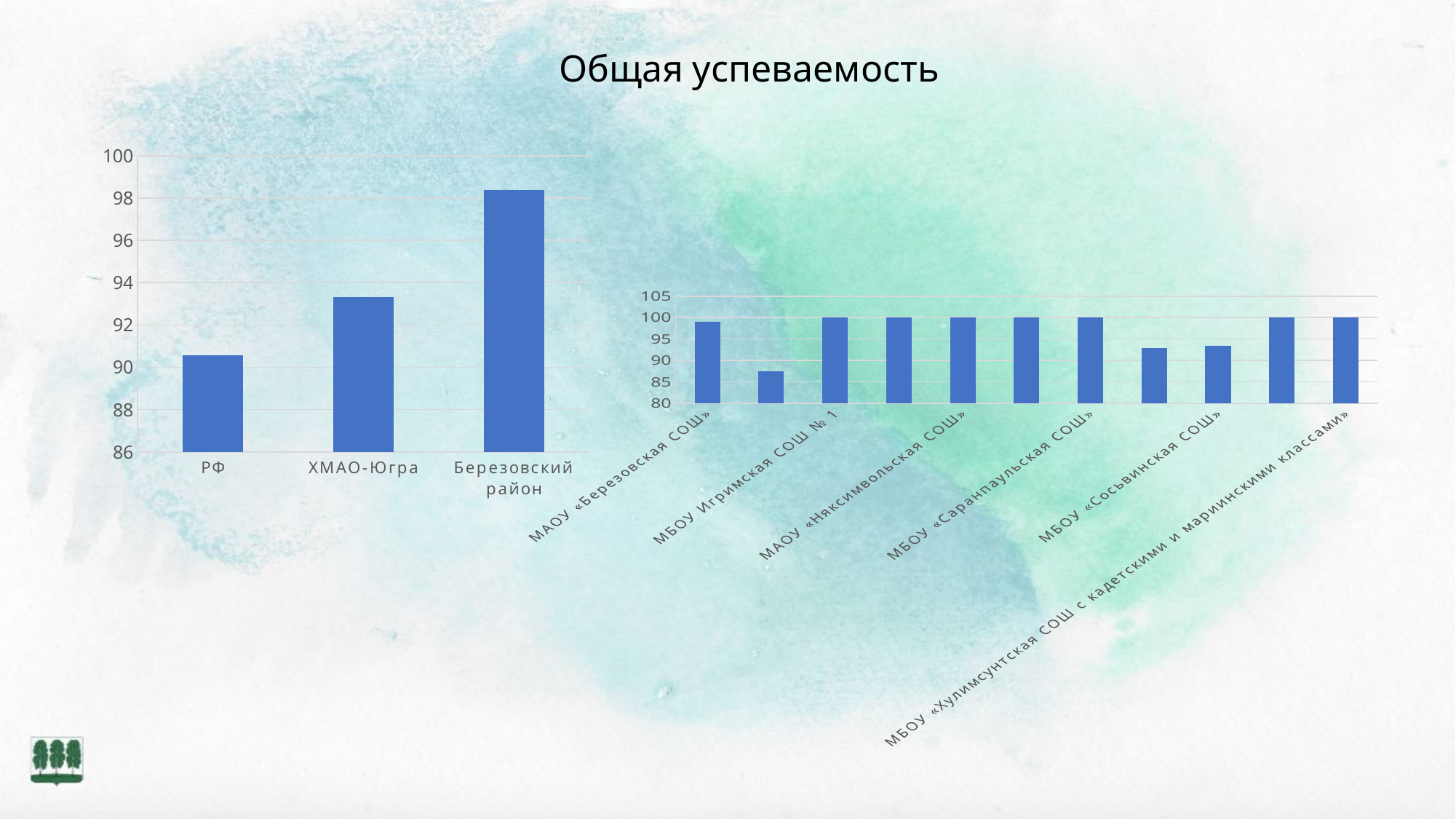
In the left chart, which category has the lowest value? РФ How many categories does the left chart show? 3 In the left chart, which is larger, the value for ХМАО-Югра or the value for РФ? ХМАО-Югра How many bars does the right chart show? 11 In the right chart, is the value for МАОУ «Березовская СОШ» greater or less than 95? greater In the left chart, which category has the highest value? Березовский район In the right chart, is the value for МБОУ «Сосьвинская СОШ» greater or less than 95? less In the left chart, is the value for РФ greater or less than 92? less What kind of chart is the left chart on the slide? bar chart In the left chart, do the values rise or fall from left to right along the x axis? rise What is the title of the slide? Общая успеваемость